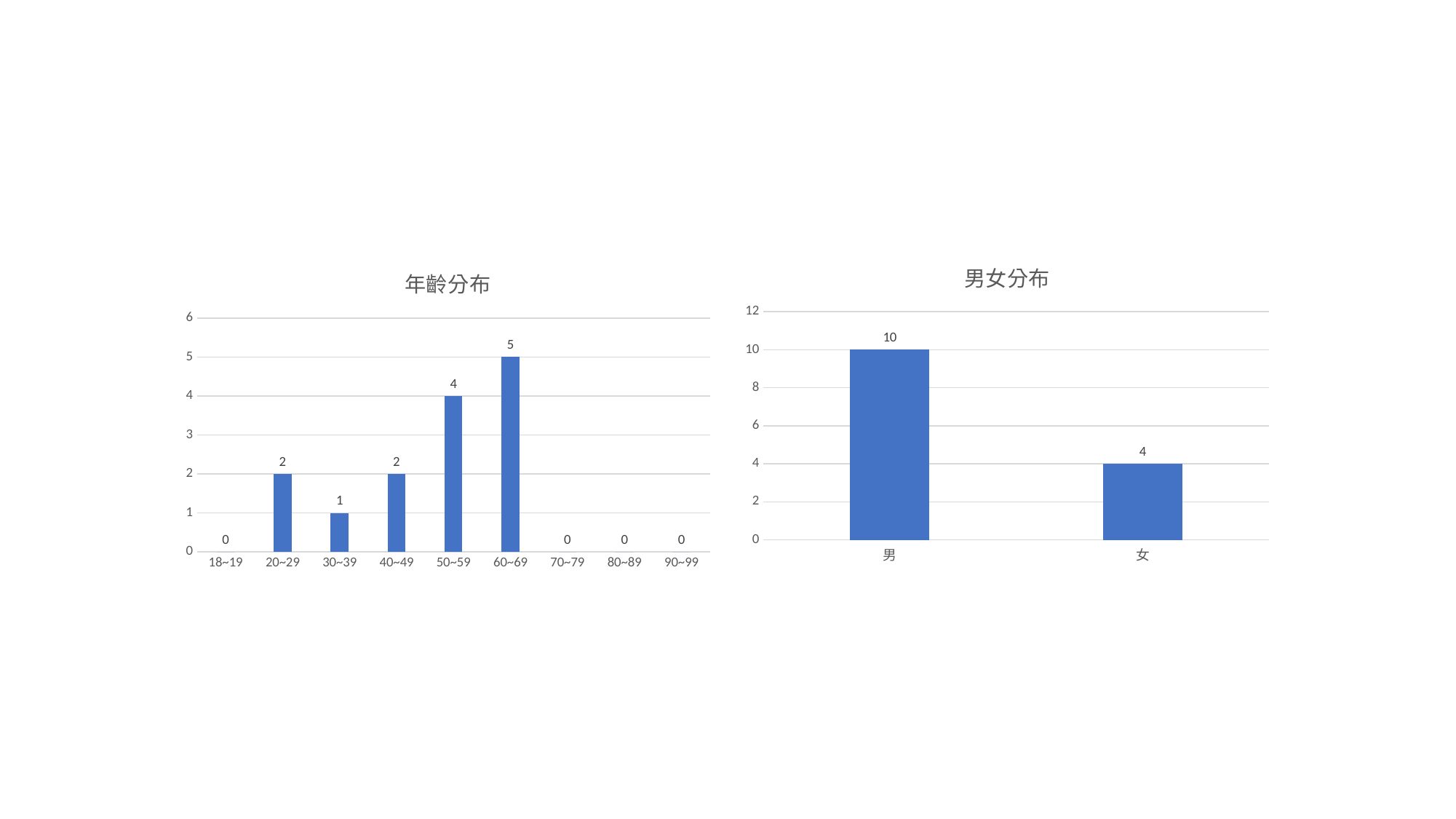
In the 年齢分布 chart, which is larger, the value for 20~29 or the value for 50~59? 50~59 In the 年齢分布 chart, how many age groups have a value of 0? 4 In the 年齢分布 chart, which age group has the highest value? 60~69 In the 年齢分布 chart, what is the value for 30~39? 1 In the 男女分布 chart, what is the difference between the values for 男 and 女? 6 In the 男女分布 chart, what is the value for 女? 4 What kind of chart is the 男女分布 chart? Bar chart In the 男女分布 chart, what is the value for 男? 10 In the 年齢分布 chart, what is the value for 60~69? 5 In the 年齢分布 chart, what is the difference between the values for 60~69 and 50~59? 1 In the 年齢分布 chart, how many age categories are shown on the x axis? 9 In the 男女分布 chart, which category has the lowest value? 女